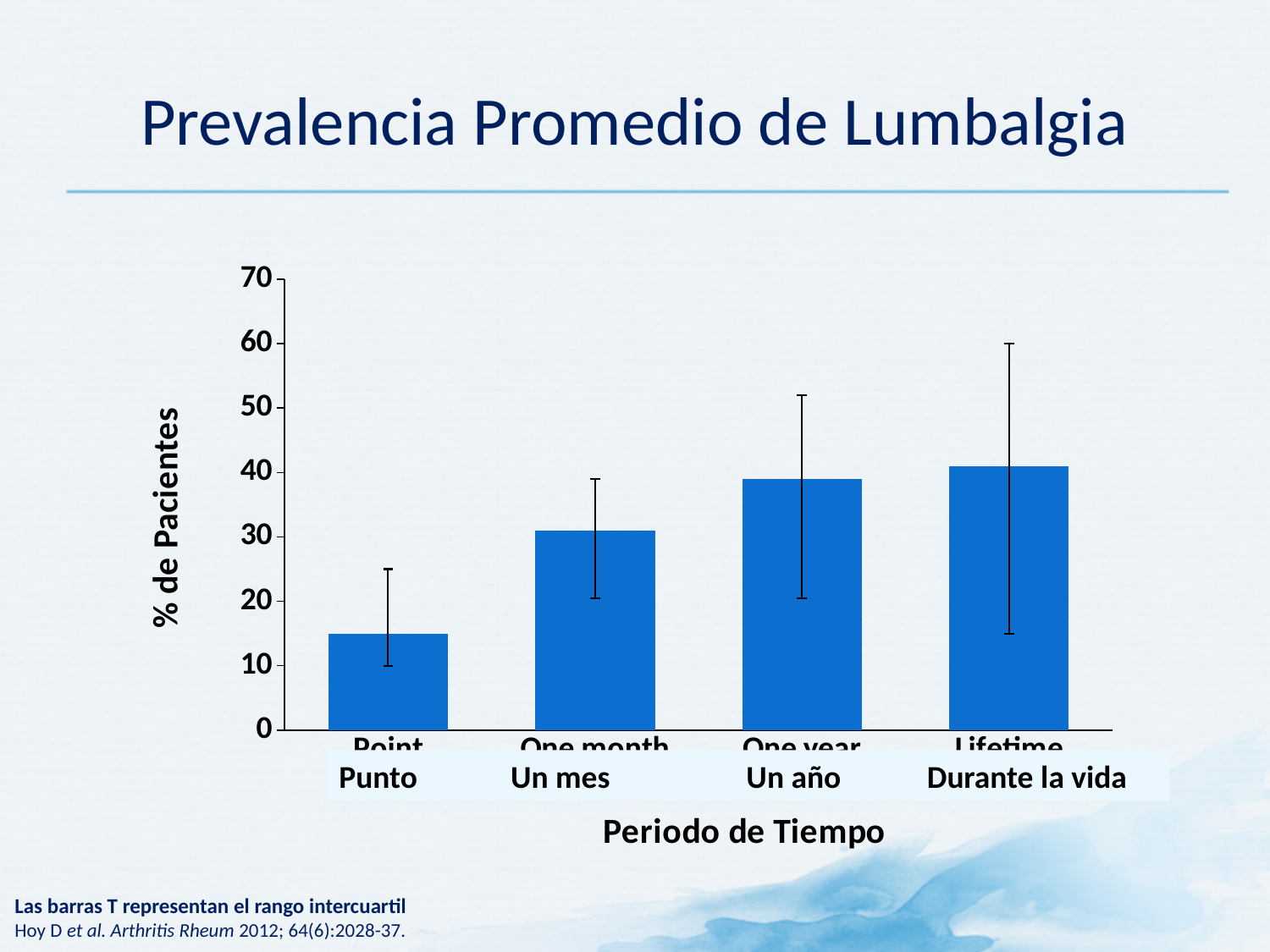
Is the value for Un mes greater or less than 20? greater What is the title of the y axis? % de Pacientes Which is larger, the value for Un año or the value for Un mes? Un año Is the value for Durante la vida greater or less than 50? less How many categories (time periods) are plotted on the chart? 4 What kind of chart is shown on the slide? bar chart Is the value for Punto greater or less than 20? less Do the values rise or fall from Punto to Durante la vida along the x axis? rise Which is larger, the value for Un mes or the value for Punto? Un mes Which time period has the lowest prevalence of lumbalgia? Punto